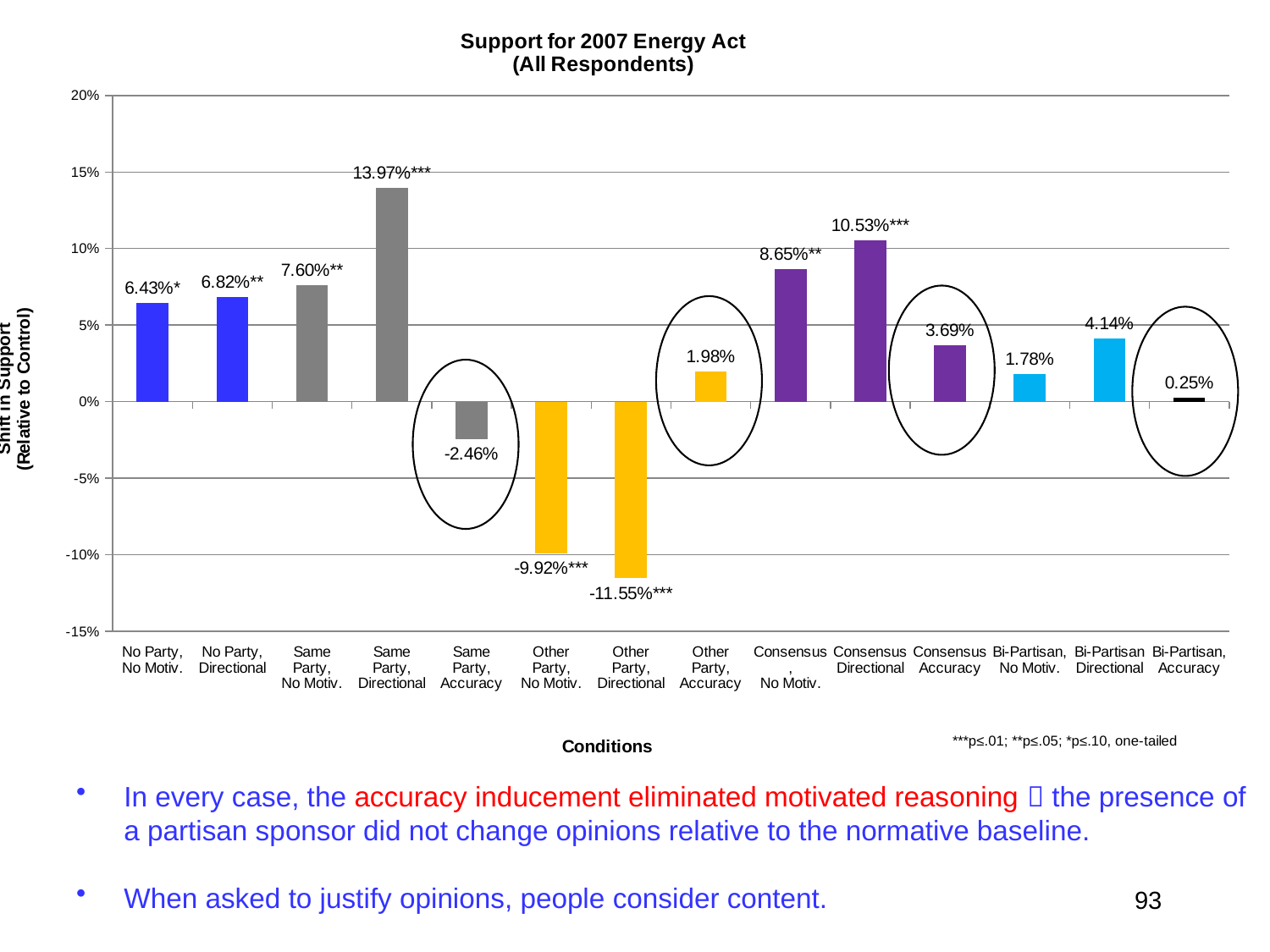
Which condition has the highest shift in support? Same Party, Directional What is the value shown for the Bi-Partisan, Accuracy condition? 0.25% What is the value shown for the Same Party, Directional condition? 13.97%*** What is the difference between the values for Same Party, Directional (13.97%) and Consensus, Directional (10.53%)? 3.44% What is the label on the x axis of the chart? Conditions What is the value shown for the Other Party, Directional condition? -11.55%*** What kind of chart is shown on the slide? bar chart What is the value shown for the Consensus, Accuracy condition? 3.69% What is the title of the chart? Support for 2007 Energy Act (All Respondents) How many conditions (categories) are plotted on the x axis? 14 Which is larger, the value for Consensus, Directional or the value for Same Party, Directional? Same Party, Directional Which condition has the lowest shift in support? Other Party, Directional